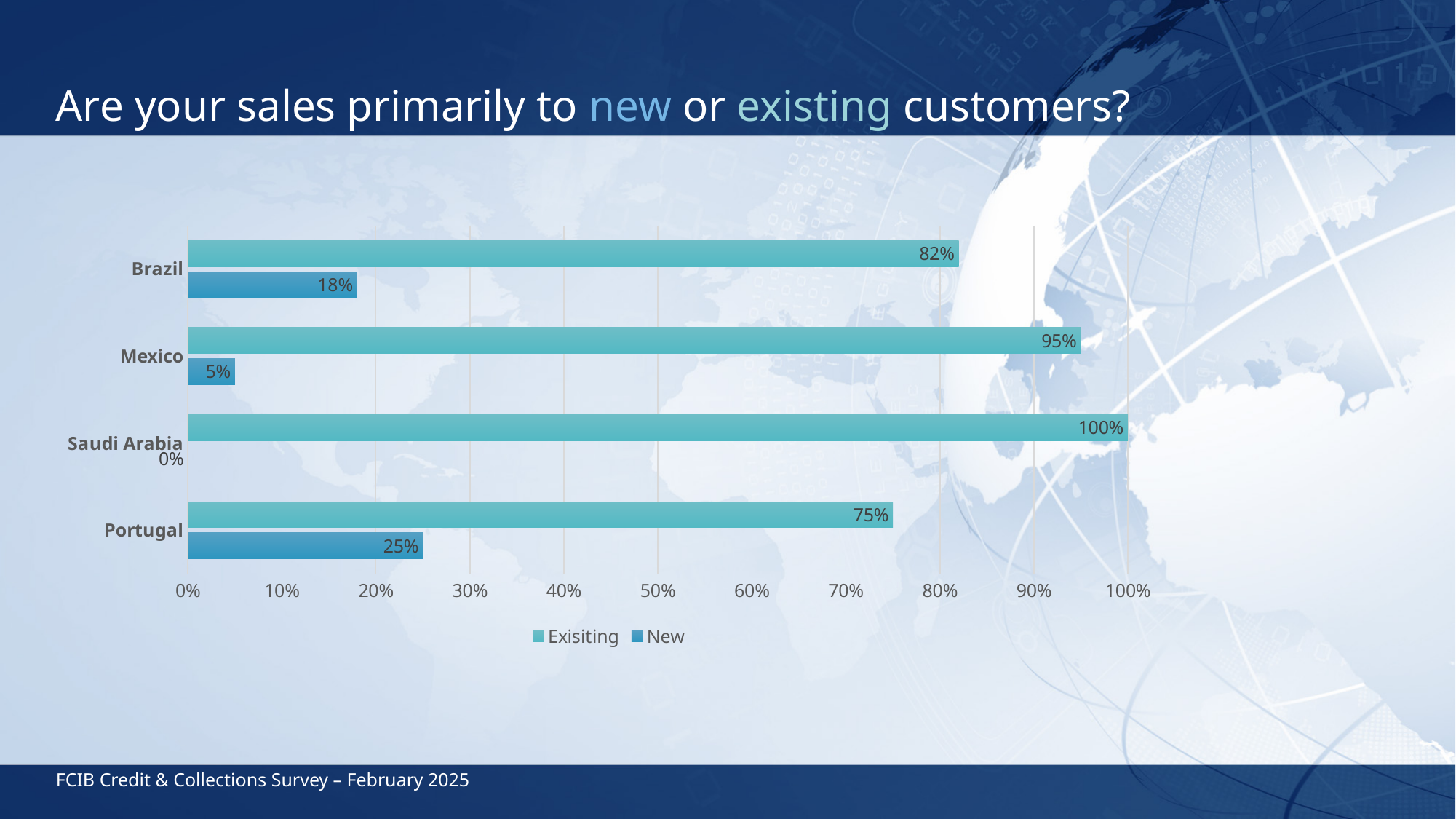
What is the difference between the existing and new customer values for Brazil? 64% What is the value for New customers in Mexico? 5% What is the value for New customers in Portugal? 25% What kind of chart is shown on the slide? Bar chart What are the two series named in the legend? Exisiting and New Which country has the highest value for existing customers? Saudi Arabia What is the value for New customers in Saudi Arabia? 0% How many series does the legend list? 2 What percentage of Brazil's sales are to existing customers? 82% How many countries are shown on the chart? 4 Which is larger: the New customer value for Portugal or for Brazil? Portugal Which country has the lowest value for existing customers? Portugal